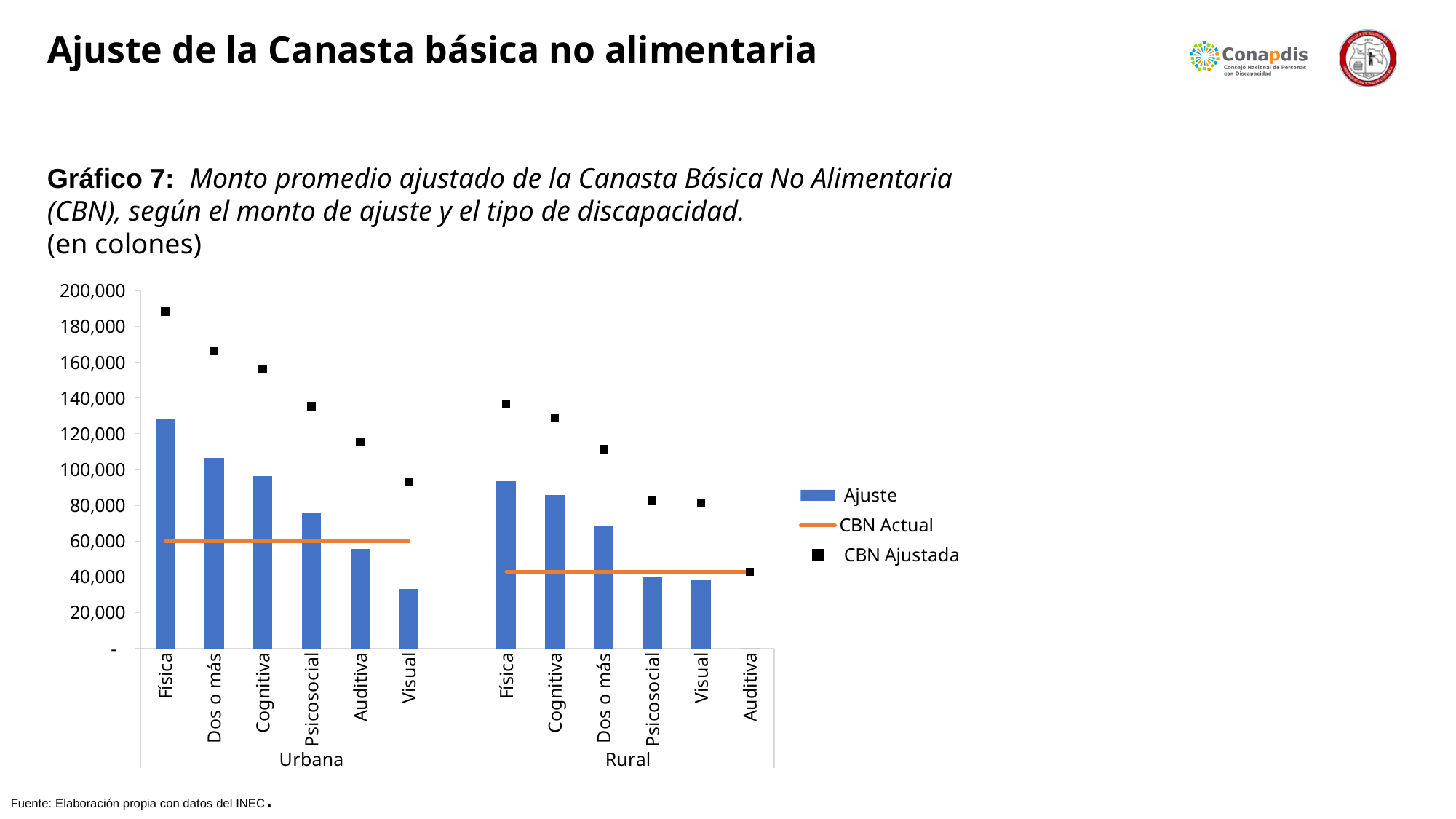
Is the Ajuste value for Visual in the Urbana group greater or less than 40,000? less What kind of chart is shown on the slide? combination bar and line chart How many series does the legend list? 3 Is the Ajuste value for Física in the Urbana group greater or less than 120,000? greater Which category has the lowest CBN Ajustada marker? Auditiva (Rural) Which category has the highest Ajuste bar? Física (Urbana) What are the three entries in the chart legend? Ajuste, CBN Actual, CBN Ajustada Which is larger, the Ajuste value for Cognitiva in Urbana or for Cognitiva in Rural? Cognitiva in Urbana How many disability categories are shown under the Urbana group? 6 How many bars are plotted in total across the Urbana and Rural groups? 11 Is the CBN Ajustada value for Física in the Urbana group greater or less than 180,000? greater Do the Ajuste bars rise or fall from left to right within the Urbana group? fall